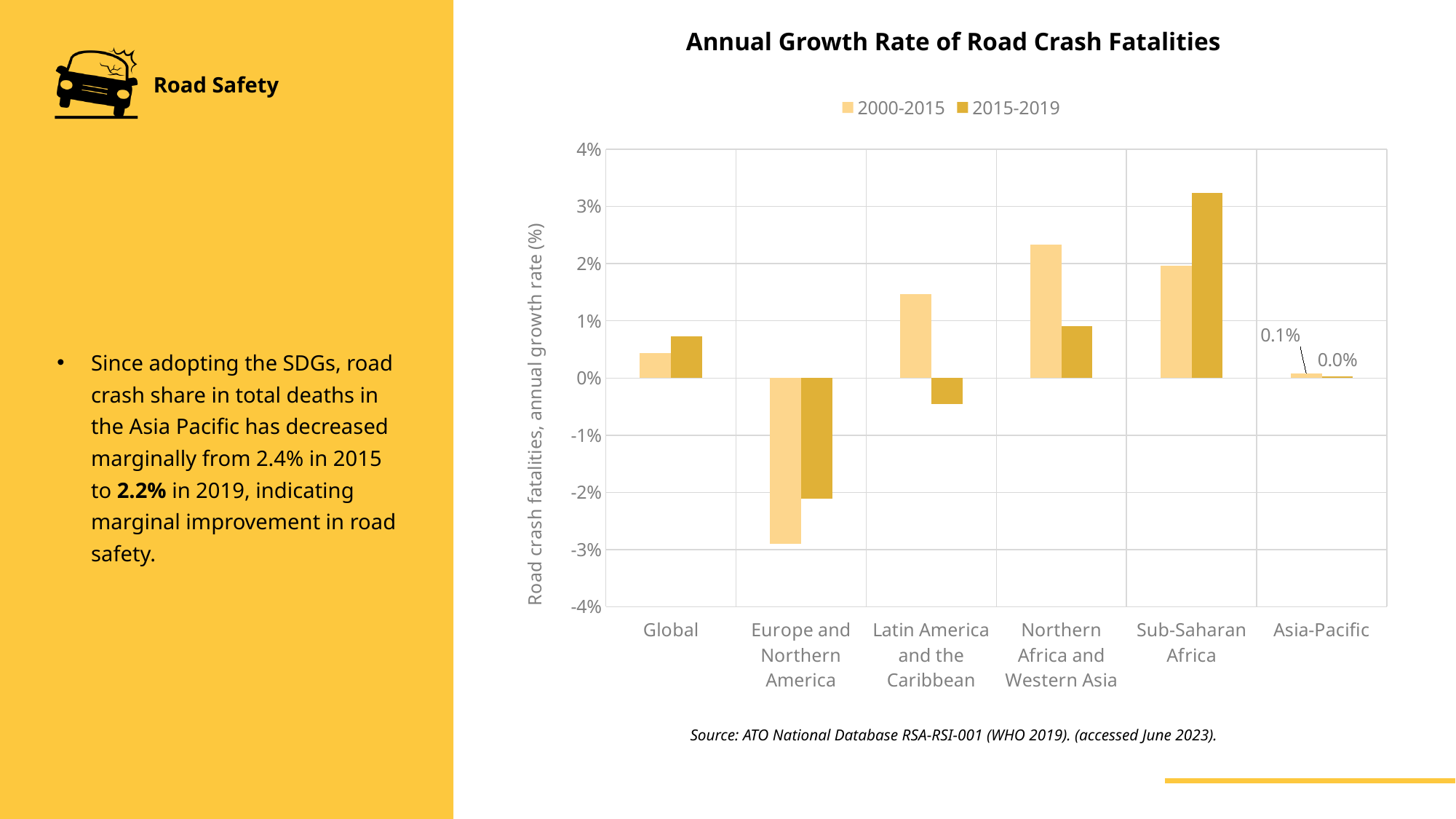
What is the 2015-2019 annual growth rate for Asia-Pacific? 0.0% For Sub-Saharan Africa, which period has the larger annual growth rate, 2000-2015 or 2015-2019? 2015-2019 Which region has the lowest 2000-2015 annual growth rate? Europe and Northern America For Northern Africa and Western Asia, which period has the larger annual growth rate, 2000-2015 or 2015-2019? 2000-2015 Is the 2000-2015 value for Europe and Northern America greater or less than -2%? less Is the 2015-2019 value for Sub-Saharan Africa greater or less than 3%? greater How many regions (categories) are shown on the x axis? 6 What is the title of the chart? Annual Growth Rate of Road Crash Fatalities How many series does the legend list? 2 What is the 2000-2015 annual growth rate for Asia-Pacific? 0.1% Which region has the highest 2015-2019 annual growth rate? Sub-Saharan Africa What kind of chart is shown on the slide? bar chart